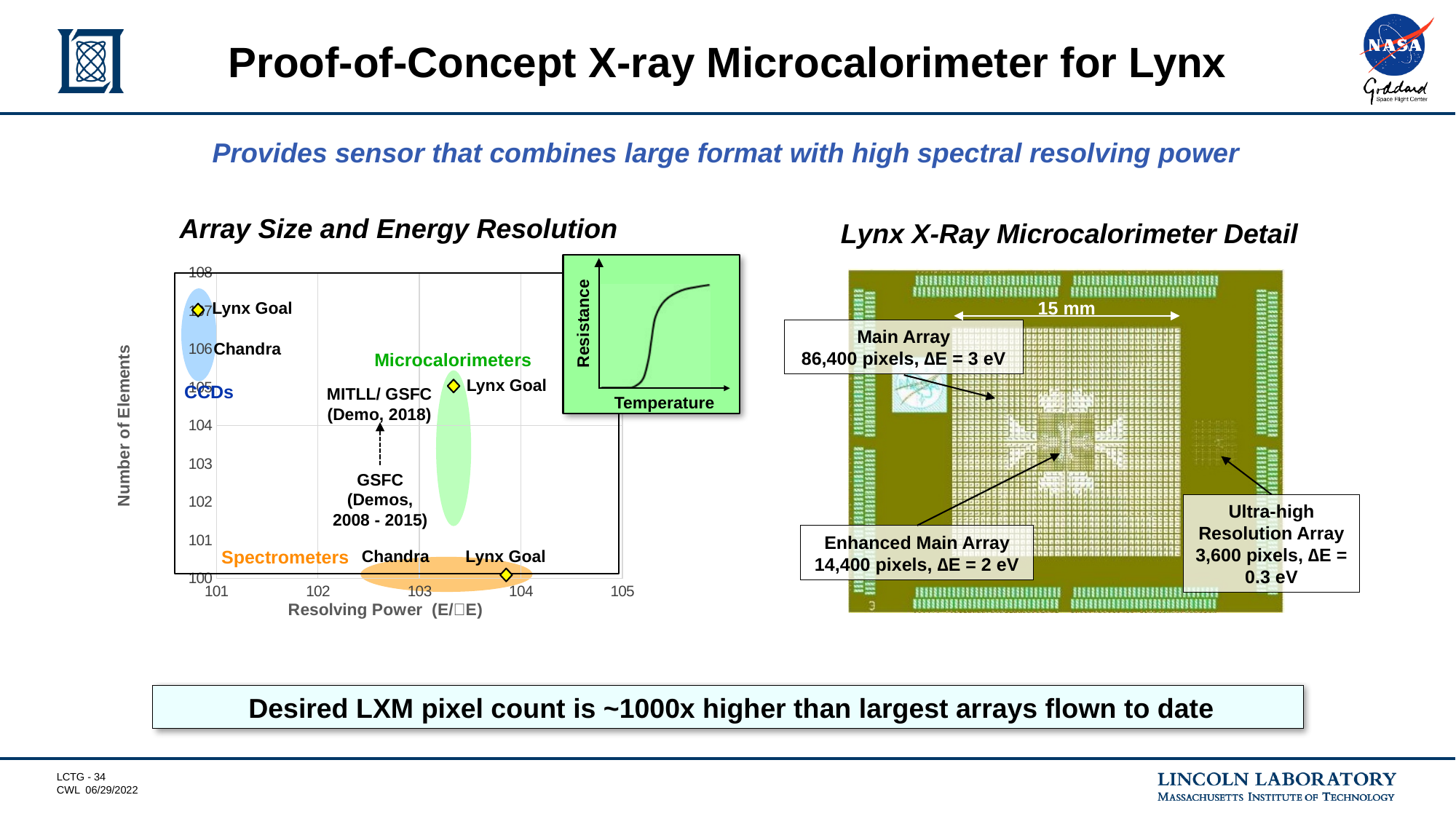
In the 'Array Size and Energy Resolution' chart, which y-axis tick does the Spectrometers 'Lynx Goal' marker sit on? 100 What kind of chart is 'Array Size and Energy Resolution'? Scatter chart In the 'Array Size and Energy Resolution' chart, which 'Lynx Goal' marker has the highest Number of Elements: CCDs, Microcalorimeters or Spectrometers? CCDs In the 'Array Size and Energy Resolution' chart, which has the higher Resolving Power: the Spectrometers 'Lynx Goal' marker or the Microcalorimeters 'Lynx Goal' marker? Spectrometers Lynx Goal In the 'Array Size and Energy Resolution' chart, what is the y-axis title? Number of Elements In the 'Array Size and Energy Resolution' chart, how many 'Lynx Goal' markers are plotted? 3 In the 'Array Size and Energy Resolution' chart, which y-axis tick does the Microcalorimeters 'Lynx Goal' marker sit on? 105 In the inset Resistance vs Temperature chart, does resistance rise or fall as temperature increases? Rises In the 'Array Size and Energy Resolution' chart, which y-axis tick does the CCDs 'Lynx Goal' marker sit on? 107 In the 'Array Size and Energy Resolution' chart, which has the higher Number of Elements: the CCDs 'Chandra' point or the Microcalorimeters 'Lynx Goal' marker? CCDs Chandra In the 'Array Size and Energy Resolution' chart, which 'Lynx Goal' marker has the lowest Number of Elements: CCDs, Microcalorimeters or Spectrometers? Spectrometers In the 'Array Size and Energy Resolution' chart, what is the x-axis title? Resolving Power (E/ΔE)